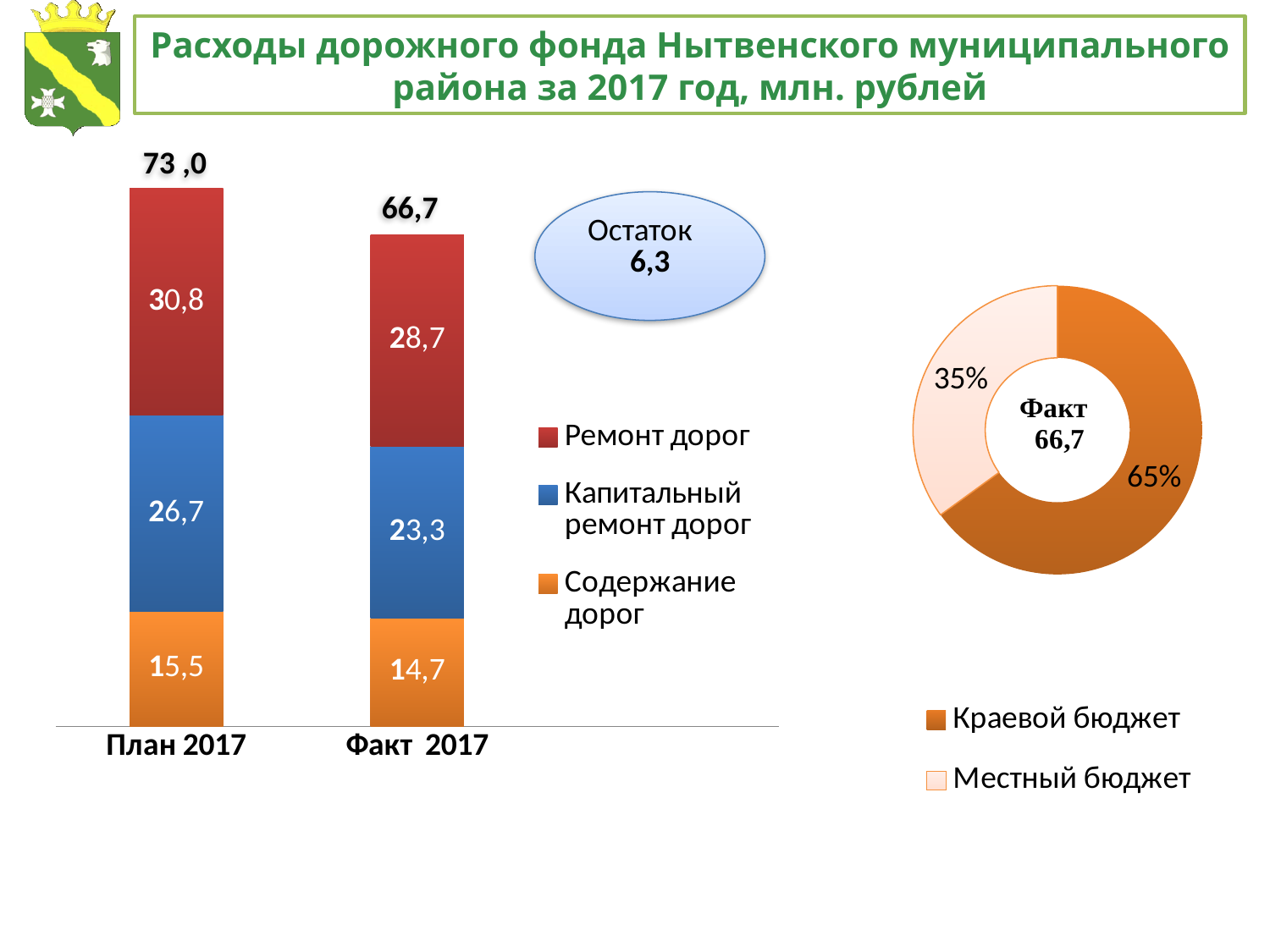
What kind of chart is the chart on the left of the slide? Stacked bar chart In the doughnut chart on the right, which slice is the smallest? Местный бюджет In the stacked bar chart on the left, which is larger: Содержание дорог in План 2017 or in Факт 2017? План 2017 In the stacked bar chart on the left, what is the difference between Капитальный ремонт дорог in План 2017 and in Факт 2017? 3,4 How many series does the legend of the stacked bar chart on the left list? 3 In the stacked bar chart on the left, what is the value for Ремонт дорог in План 2017? 30,8 In the stacked bar chart on the left, what is the total of the Факт 2017 bar? 66,7 In the stacked bar chart on the left, what is the value for Капитальный ремонт дорог in Факт 2017? 23,3 In the stacked bar chart on the left, what is the total of the План 2017 bar? 73 ,0 In the doughnut chart on the right, what share does Краевой бюджет have? 65% In the stacked bar chart on the left, which series has the lowest value in Факт 2017? Содержание дорог In the stacked bar chart on the left, what is the value for Содержание дорог in План 2017? 15,5